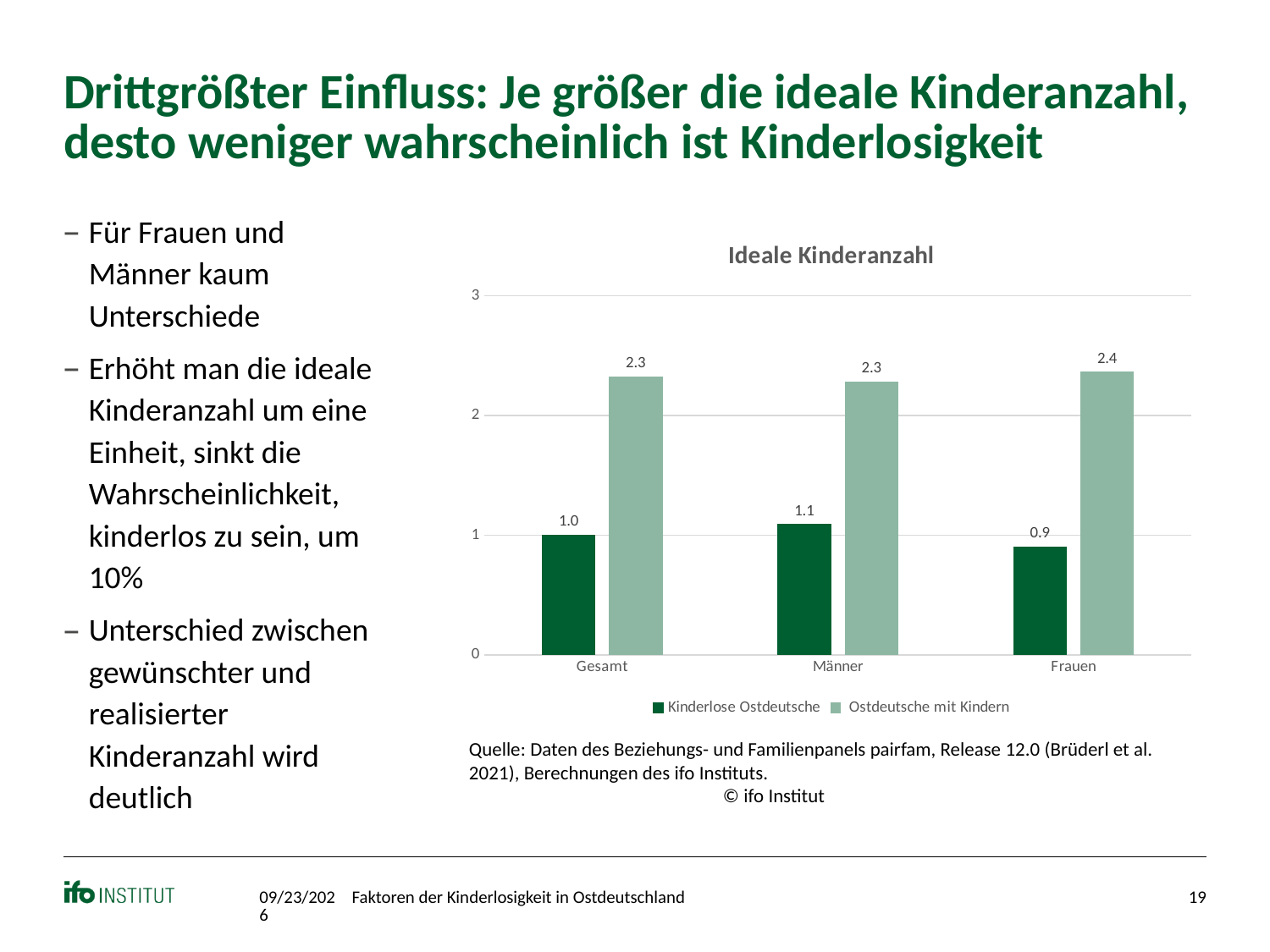
What is the title of the chart? Ideale Kinderanzahl What is the value for Ostdeutsche mit Kindern in the Frauen category? 2.4 Which category has the lowest value for Kinderlose Ostdeutsche? Frauen How many categories are shown on the x axis? 3 Is the value for Ostdeutsche mit Kindern in the Männer category greater or less than 2? greater What is the difference between Ostdeutsche mit Kindern and Kinderlose Ostdeutsche in the Frauen category? 1.5 Which category has the highest value for Kinderlose Ostdeutsche? Männer How many series does the legend list? 2 Which is larger in the Männer category: Kinderlose Ostdeutsche or Ostdeutsche mit Kindern? Ostdeutsche mit Kindern What is the value for Kinderlose Ostdeutsche in the Männer category? 1.1 What is the value for Kinderlose Ostdeutsche in the Gesamt category? 1.0 What is the difference between Ostdeutsche mit Kindern and Kinderlose Ostdeutsche in the Gesamt category? 1.3